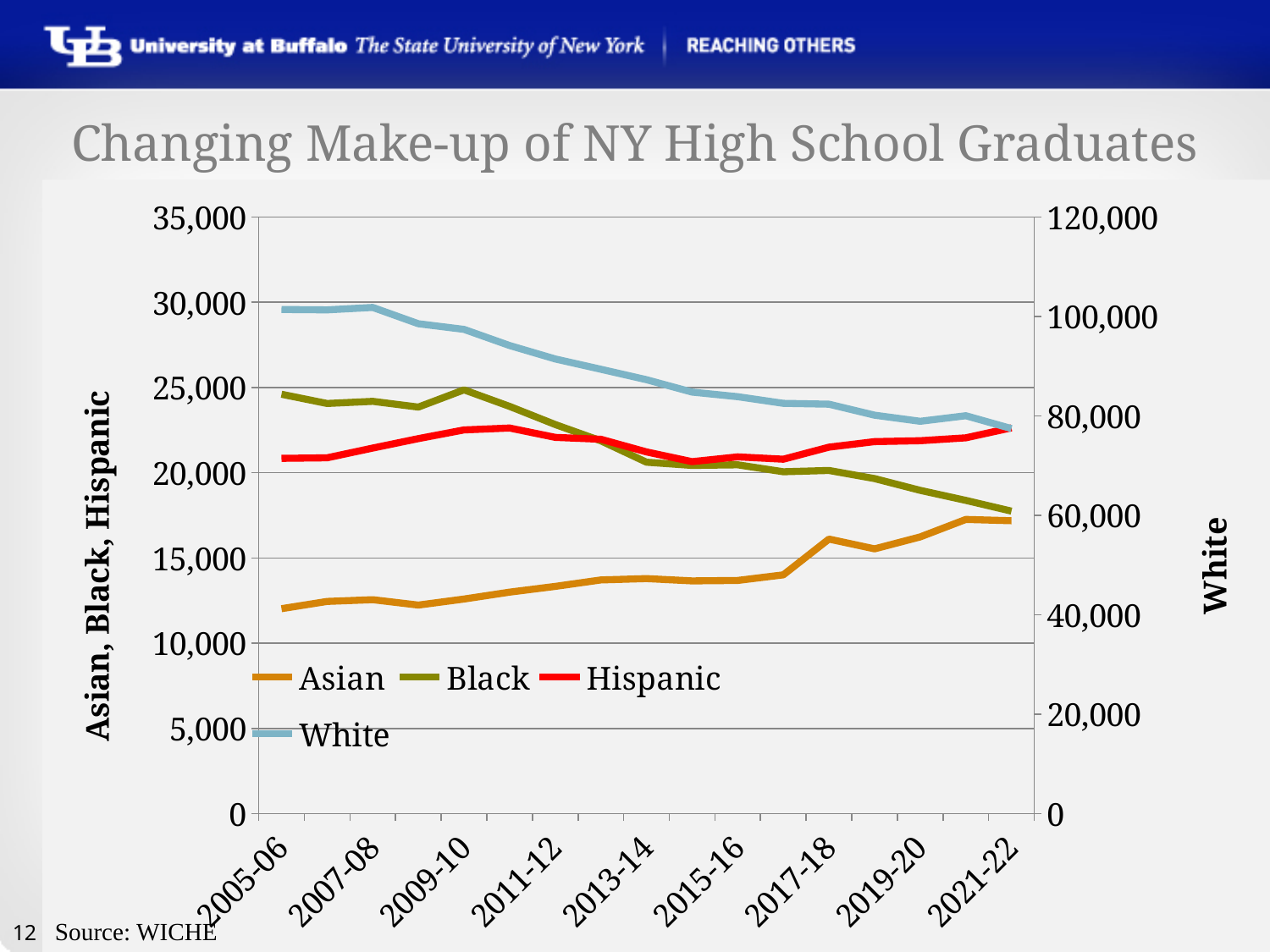
Is the value for White in 2021-22 greater or less than 80,000? less Does the White line rise or fall from 2005-06 to 2021-22? fall Is the value for Asian in 2005-06 greater or less than 15,000? less What is the title of the chart? Changing Make-up of NY High School Graduates How many series does the legend list? 4 Is the value for Asian in 2021-22 greater or less than 15,000? greater Does the Asian line rise or fall from 2005-06 to 2021-22? rise Which series is plotted on the right-hand axis? White What kind of chart is shown on the slide? line chart In 2021-22, which is larger, the Hispanic value or the Black value? Hispanic In 2005-06, which is larger, the Black value or the Hispanic value? Black